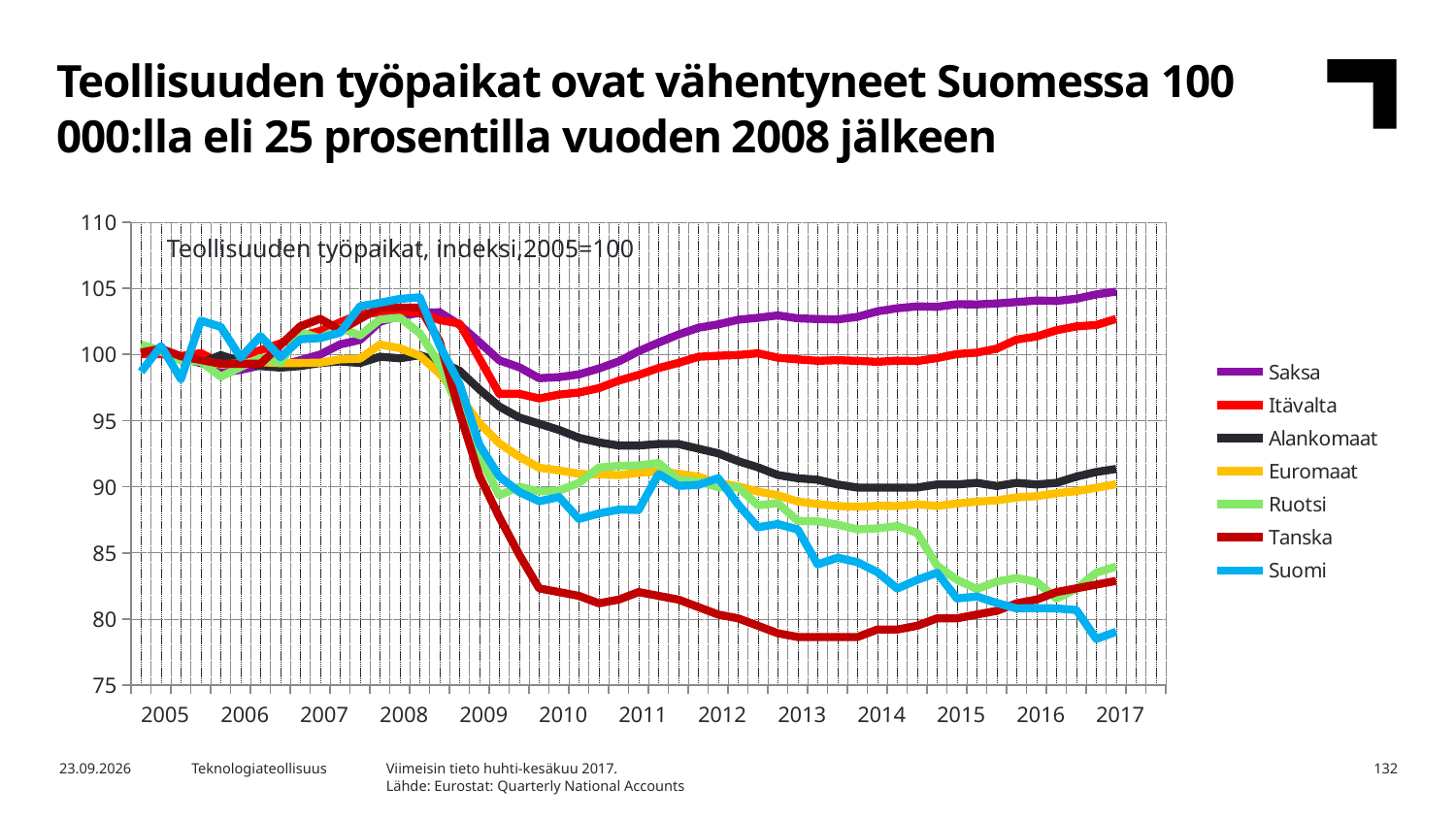
Which series has the lowest value in 2013? Tanska Which countries or regions are listed in the chart legend? Saksa, Itävalta, Alankomaat, Euromaat, Ruotsi, Tanska, Suomi How many series does the chart legend list? 7 Is the value for Saksa in 2017 greater or less than 100? greater Which series has the lowest value at the end of the chart in 2017? Suomi Is the value for Alankomaat in 2017 greater or less than 95? less Which is higher in 2017, Saksa or Suomi? Saksa Does the Saksa line rise or fall between 2010 and 2017? rise What kind of chart is shown on the slide? line chart Is the value for Suomi in 2017 greater or less than 85? less Which series has the highest value at the end of the chart in 2017? Saksa What is the title printed inside the chart area? Teollisuuden työpaikat, indeksi,2005=100